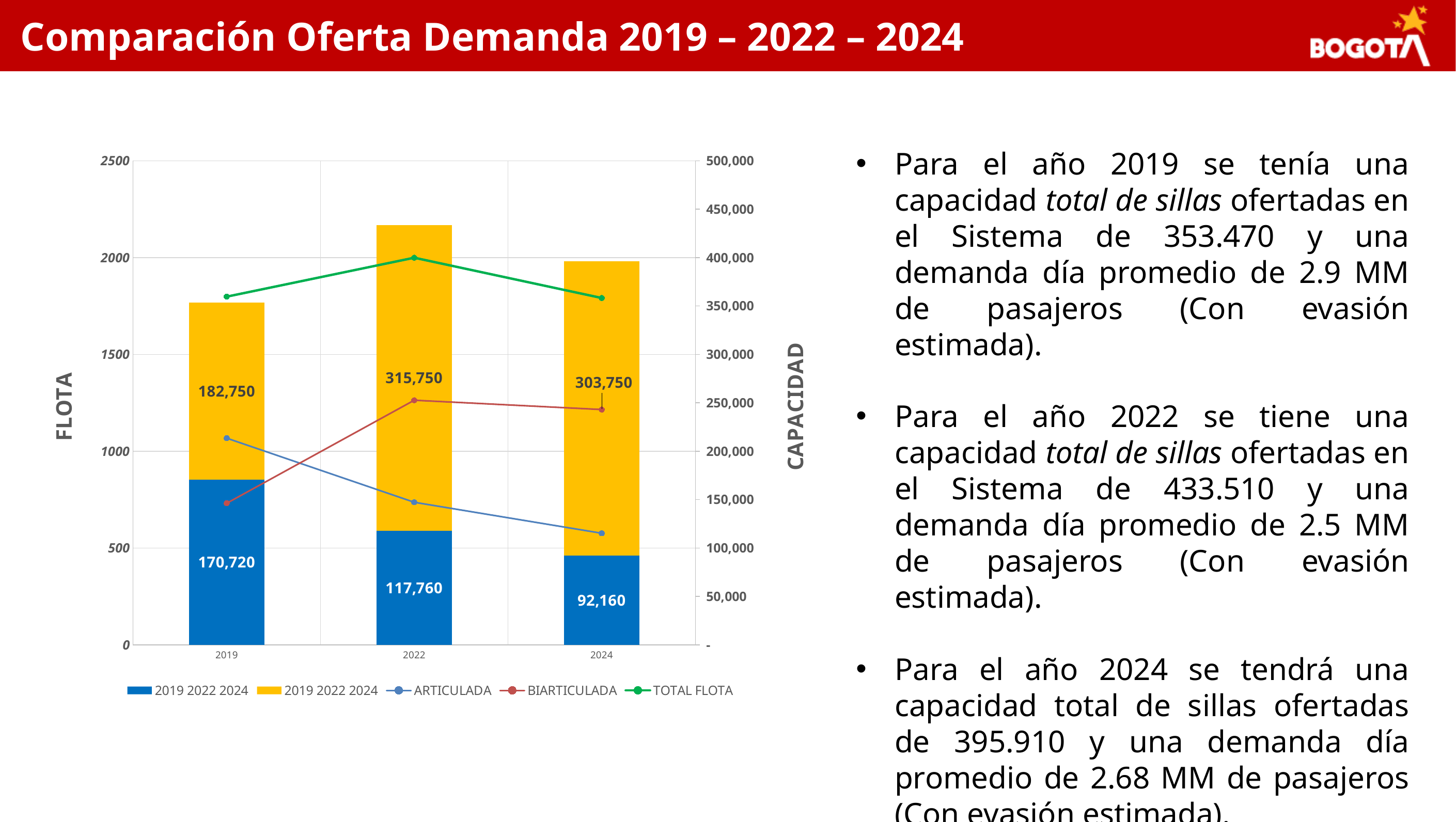
In which year is the yellow bar segment the largest? 2022 Is the TOTAL FLOTA value for 2019 greater or less than 1500 on the FLOTA axis? greater What is the value of the blue bar segment for 2019? 170,720 How many series does the legend list? 5 In which year is the blue bar segment the smallest? 2024 What is the value of the yellow bar segment for 2022? 315,750 Does the ARTICULADA line rise or fall from 2019 to 2024? fall What is the value of the blue bar segment for 2024? 92,160 What is the total of the stacked bar for 2022? 433,510 How many years are shown on the x axis? 3 What is the total of the stacked bar for 2019? 353,470 What is the difference between the yellow bar segment values for 2022 and 2024? 12,000